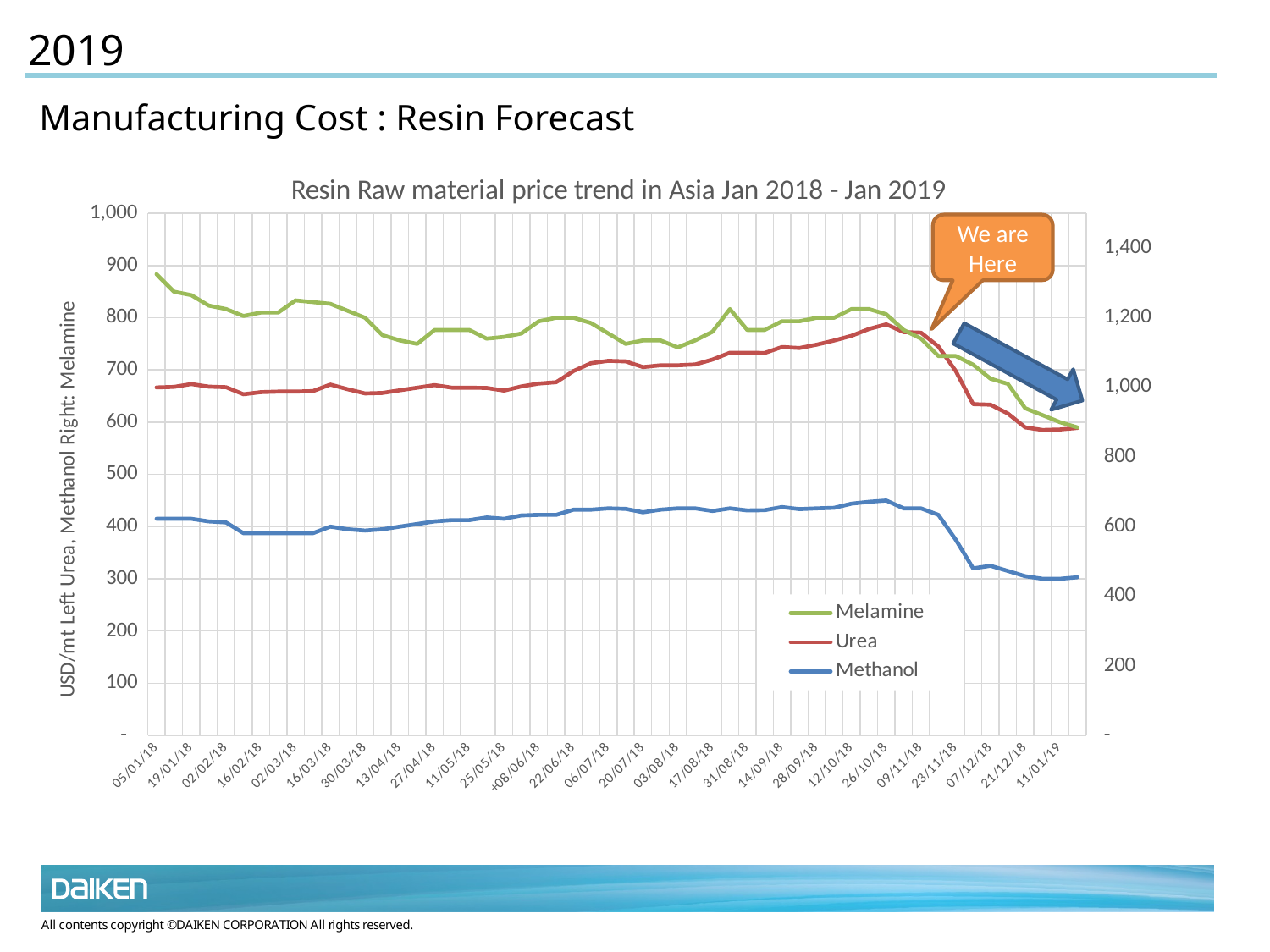
Does the Methanol line rise or fall between 26/10/18 and 11/01/19? fall What does the callout on the chart say? We are Here Is the value for Melamine at 11/01/19, read on the right axis, greater or less than 1,000? less What is the title of the chart? Resin Raw material price trend in Asia Jan 2018 - Jan 2019 Is the value for Methanol at 26/10/18 greater or less than 400? greater Is the value for Urea at 26/10/18 greater or less than 700? greater At 05/01/18, which is larger on the left axis: Urea or Methanol? Urea How many series does the chart legend list? 3 Does the Urea line rise or fall between 26/10/18 and 11/01/19? fall What kind of chart is shown on the slide? line chart